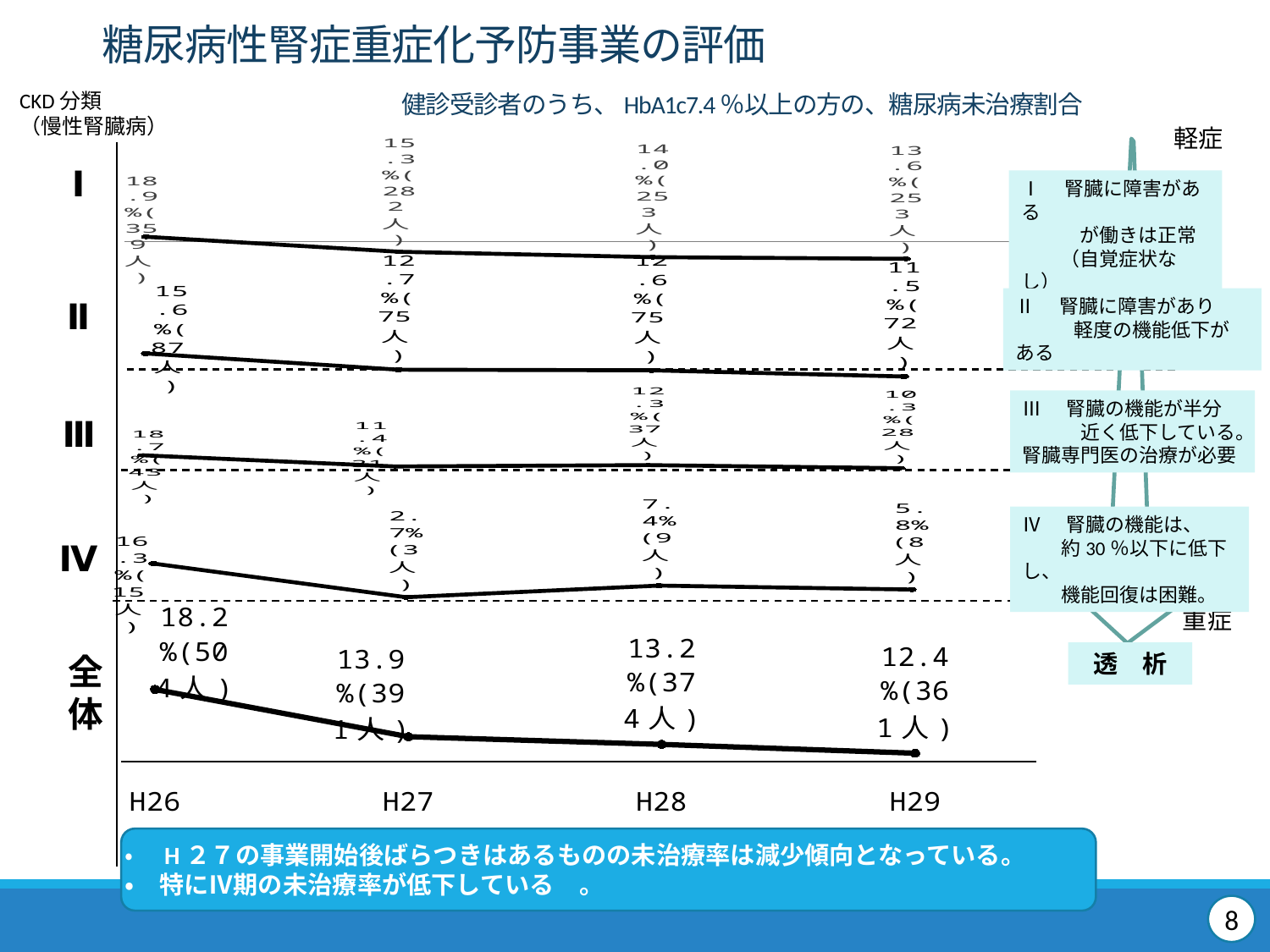
Does the 全体 untreated rate rise or fall from H26 to H29? fall By how many percentage points did the 全体 untreated rate fall from H26 to H29? 5.8 In which year is the untreated rate for stage IV highest? H26 What is the untreated rate for CKD stage I in H28? 14.0% What is the untreated rate for 全体 in H29? 12.4% What is the untreated rate for CKD stage IV in H27? 2.7% What is the untreated rate for CKD stage II in H29? 11.5% In which year is the untreated rate for stage IV lowest? H27 What kind of chart is shown on the slide? line chart What is the untreated rate for 全体 in H26? 18.2% How many people does the 全体 label for H27 show? 391人 How many years (points) are shown along the x axis? 4